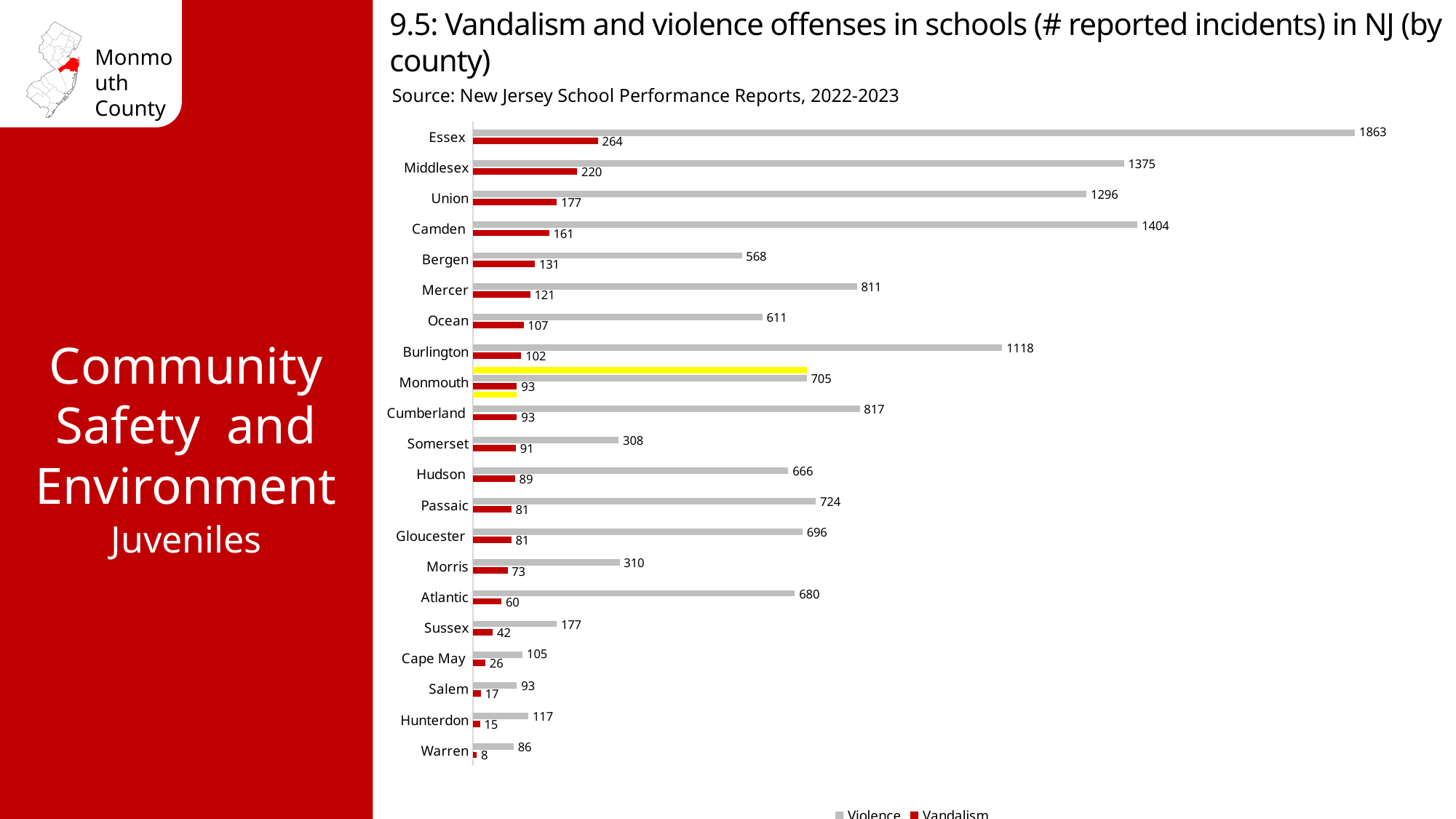
What type of chart is shown on the slide? Bar chart Which county has the lowest number of reported vandalism incidents? Warren What is the number of reported violence incidents in Camden County? 1404 What is the number of reported vandalism incidents in Monmouth County? 93 What is the difference between the violence incidents in Essex and Middlesex counties? 488 How many counties are shown in the chart? 21 Which county has the highest number of reported violence incidents? Essex Which county has more reported violence incidents, Camden or Union? Camden Which county's bars are highlighted in yellow on the chart? Monmouth What is the number of reported violence incidents in Essex County? 1863 How many series does the legend list? 2 What is the difference between violence and vandalism incidents in Monmouth County? 612